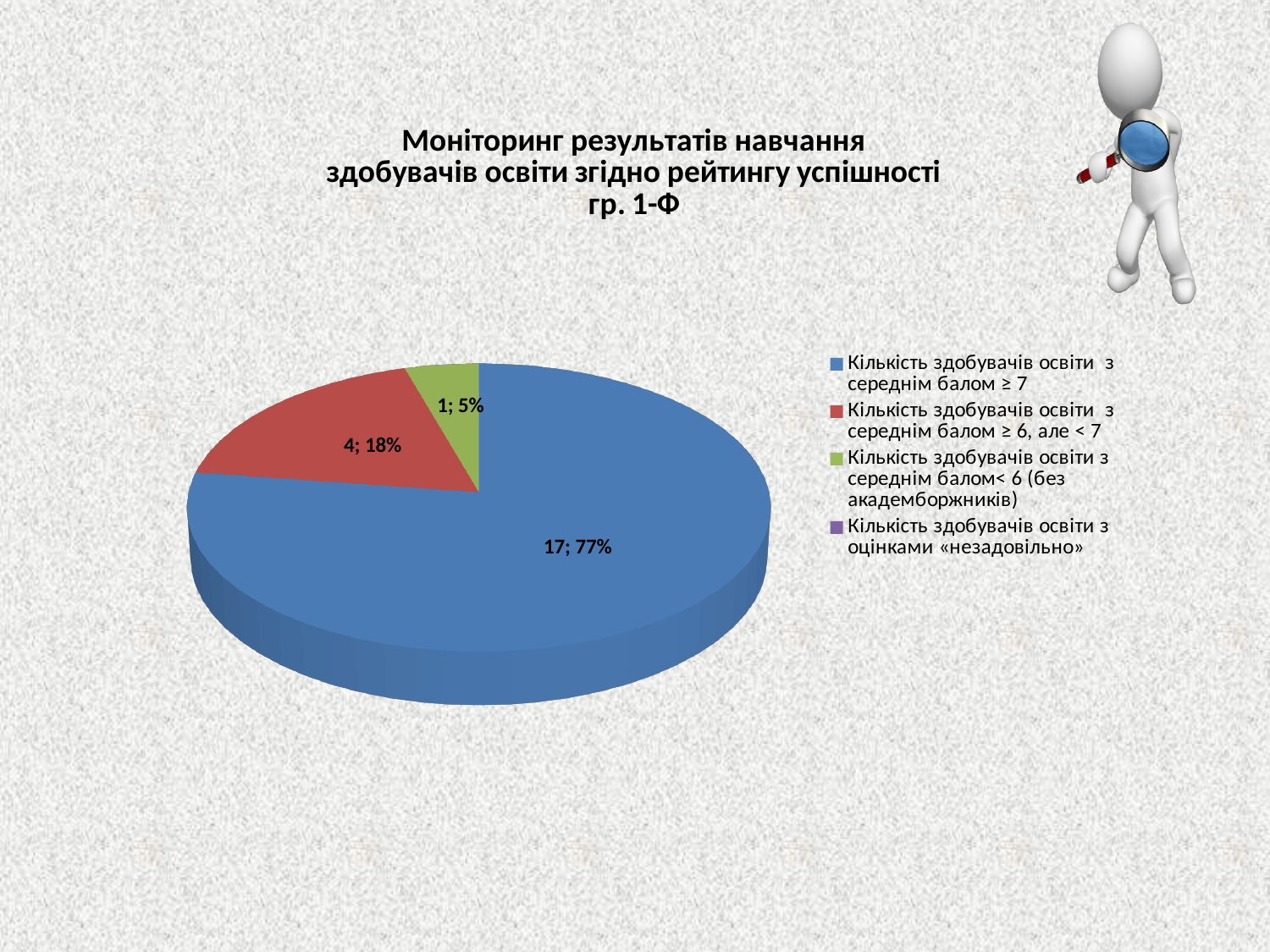
What share of the pie is taken by students with an average score ≥ 6 but < 7? 18% How many entries does the legend list? 4 How many students have an average score ≥ 7 (Кількість здобувачів освіти з середнім балом ≥ 7)? 17 How many students have an average score < 6 (без академборжників)? 1 How many students have an average score ≥ 6 but < 7? 4 What share of the pie is taken by students with an average score ≥ 7? 77% Which of the labelled slices is the smallest? Кількість здобувачів освіти з середнім балом< 6 (без академборжників) What kind of chart is shown on the slide? pie chart Which is larger: the number of students with an average score ≥ 6 but < 7, or the number with an average score < 6? Students with an average score ≥ 6 but < 7 What share of the pie is taken by students with an average score < 6? 5% Which category has the largest slice of the pie? Кількість здобувачів освіти з середнім балом ≥ 7 What is the difference between the number of students with an average score ≥ 7 and those with an average score ≥ 6 but < 7? 13